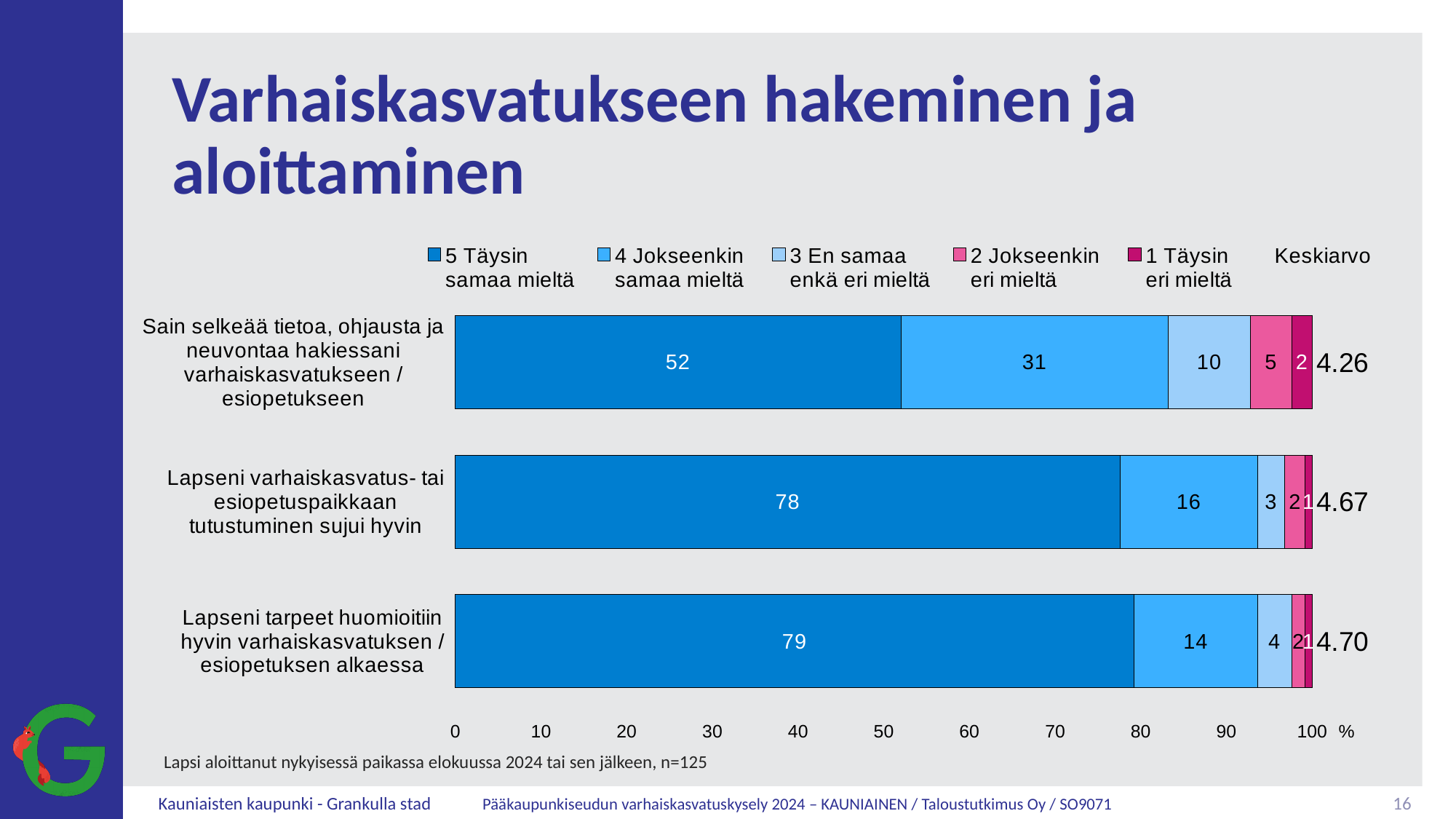
What percentage answered "4 Jokseenkin samaa mieltä" for "Lapseni tarpeet huomioitiin hyvin varhaiskasvatuksen / esiopetuksen alkaessa"? 14 Which statement has the highest Keskiarvo (mean) value? Lapseni tarpeet huomioitiin hyvin varhaiskasvatuksen / esiopetuksen alkaessa What is the total of the stacked bar for "Sain selkeää tietoa, ohjausta ja neuvontaa hakiessani varhaiskasvatukseen / esiopetukseen" (52 + 31 + 10 + 5 + 2)? 100 Is the "5 Täysin samaa mieltä" share for "Sain selkeää tietoa, ohjausta ja neuvontaa hakiessani varhaiskasvatukseen / esiopetukseen" greater or less than 60? less What kind of chart is shown on the slide? Stacked horizontal bar chart What is the Keskiarvo (mean) shown for "Lapseni varhaiskasvatus- tai esiopetuspaikkaan tutustuminen sujui hyvin"? 4.67 What percentage of respondents answered "5 Täysin samaa mieltä" to "Sain selkeää tietoa, ohjausta ja neuvontaa hakiessani varhaiskasvatukseen / esiopetukseen"? 52 What is the sample size (n) stated below the chart? n=125 Which statement has the lowest share of "5 Täysin samaa mieltä" responses? Sain selkeää tietoa, ohjausta ja neuvontaa hakiessani varhaiskasvatukseen / esiopetukseen How many statements (bars) are shown in the chart? 3 What is the difference in the "5 Täysin samaa mieltä" share between "Lapseni varhaiskasvatus- tai esiopetuspaikkaan tutustuminen sujui hyvin" and "Sain selkeää tietoa, ohjausta ja neuvontaa hakiessani varhaiskasvatukseen / esiopetukseen"? 26 Which is larger: the "3 En samaa enkä eri mieltä" share for "Sain selkeää tietoa..." or for "Lapseni tarpeet huomioitiin hyvin..."? Sain selkeää tietoa, ohjausta ja neuvontaa hakiessani varhaiskasvatukseen / esiopetukseen